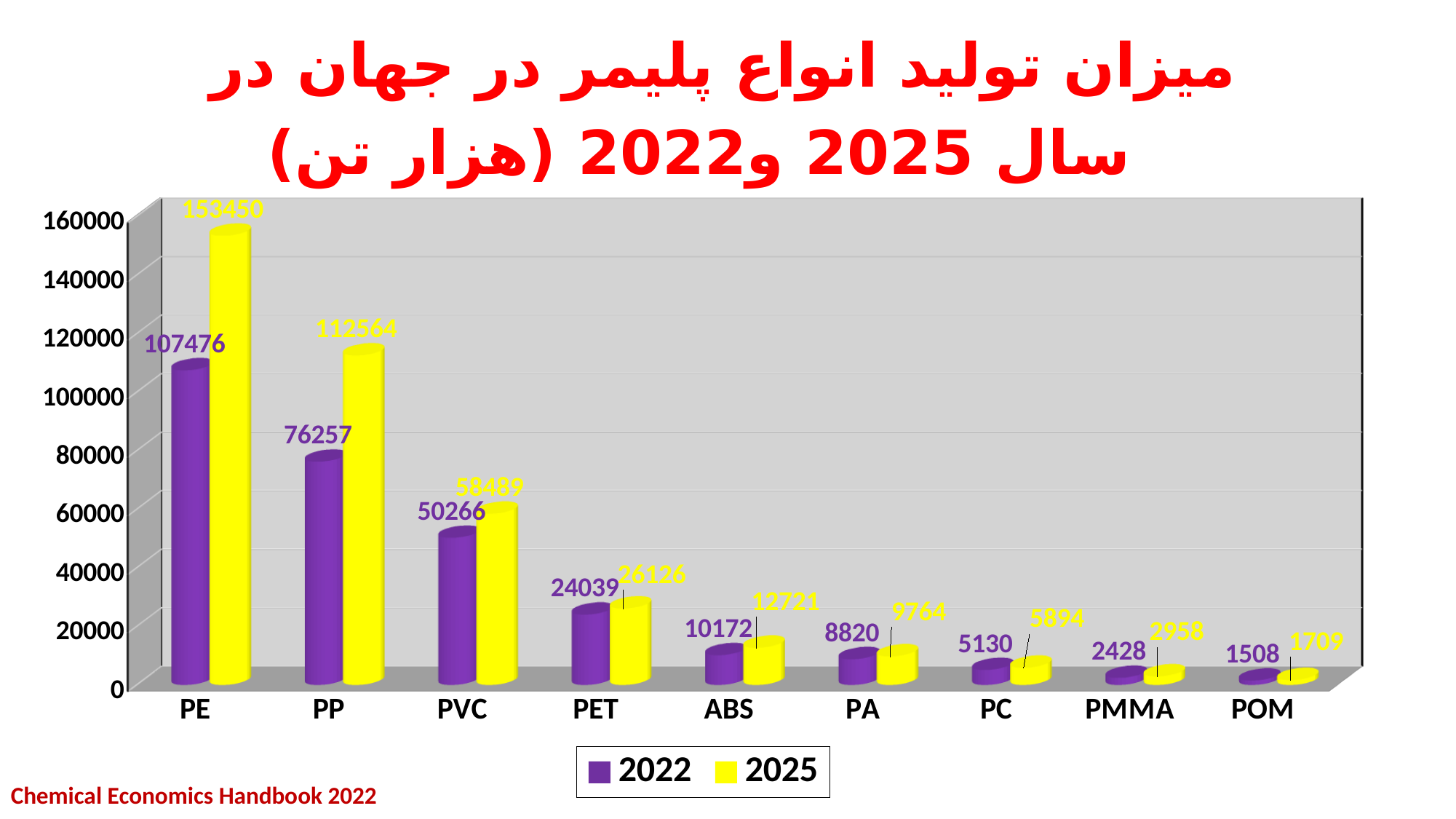
Which category has the highest 2022 value? PE Which is larger: the 2022 value for PET or the 2025 value for ABS? 2022 value for PET What kind of chart is shown on the slide? bar chart What is the 2025 value for PE? 153450 What is the 2022 value for PVC? 50266 What is the 2025 value for PA? 9764 What is the difference between the 2025 and 2022 values for PP? 36307 What is the difference between the 2025 and 2022 values for PE? 45974 How many series does the legend list? 2 Which category has the lowest 2025 value? POM Which colour represents the 2025 series in the legend? yellow How many categories are shown on the x axis? 9